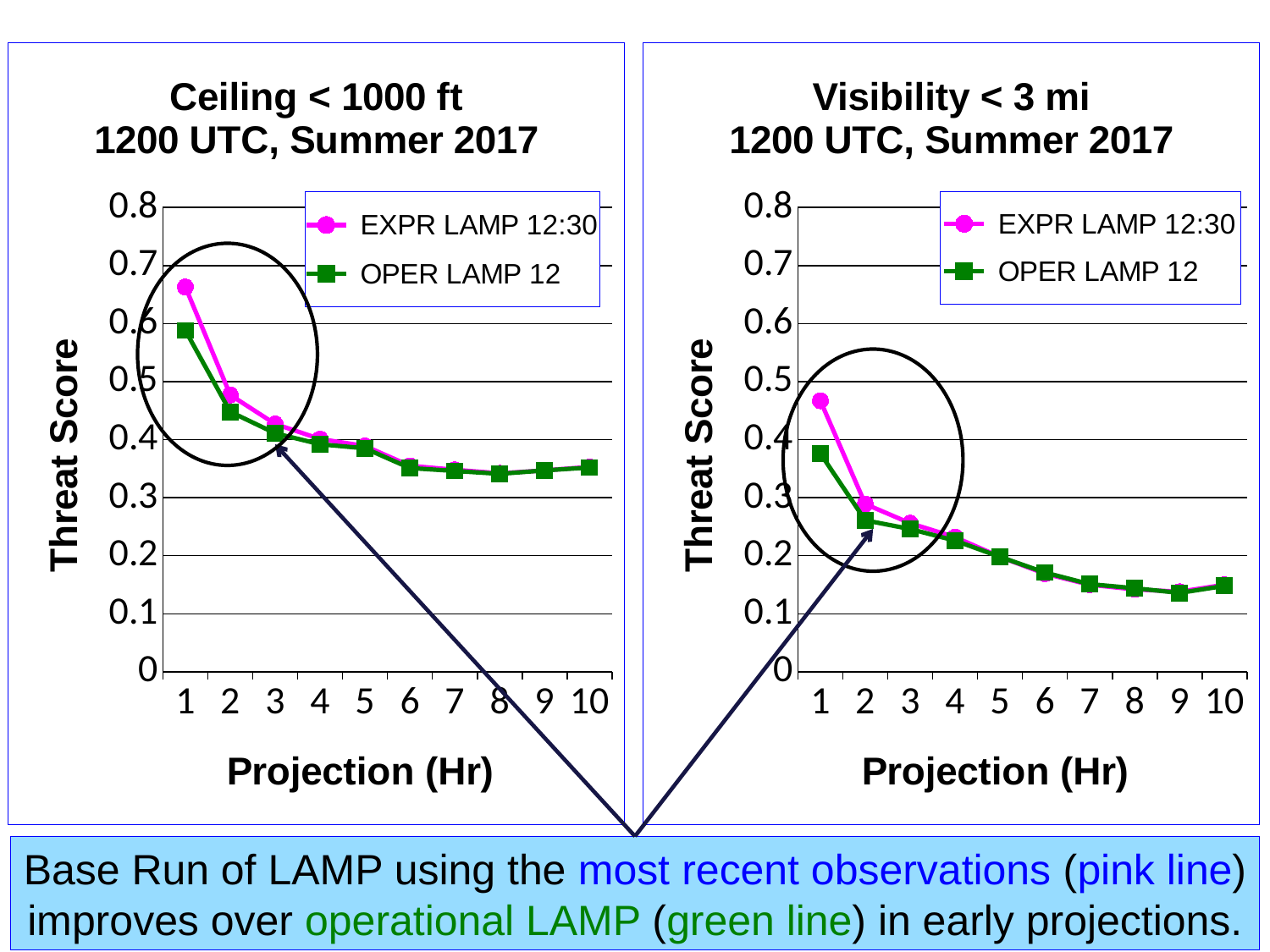
What kind of chart is the 'Ceiling < 1000 ft' chart on the left? line chart In the 'Visibility < 3 mi' chart, is the EXPR LAMP 12:30 threat score at projection hour 1 greater or less than 0.4? greater What is the y-axis label of the 'Visibility < 3 mi' chart? Threat Score In the 'Ceiling < 1000 ft' chart, is the OPER LAMP 12 threat score at projection hour 1 greater or less than 0.5? greater How many projection hours are plotted along the x axis of the 'Ceiling < 1000 ft' chart? 10 In the 'Ceiling < 1000 ft' chart, which series has the higher threat score at projection hour 1? EXPR LAMP 12:30 In the 'Ceiling < 1000 ft' chart, does the EXPR LAMP 12:30 threat score rise or fall from projection hour 1 to projection hour 5? fall How many series does the legend of the 'Visibility < 3 mi' chart list? 2 In the 'Ceiling < 1000 ft' chart, at which projection hour is the EXPR LAMP 12:30 threat score highest? 1 In the 'Ceiling < 1000 ft' chart, is the EXPR LAMP 12:30 threat score at projection hour 1 greater or less than 0.6? greater In the 'Visibility < 3 mi' chart, which series has the higher threat score at projection hour 1? EXPR LAMP 12:30